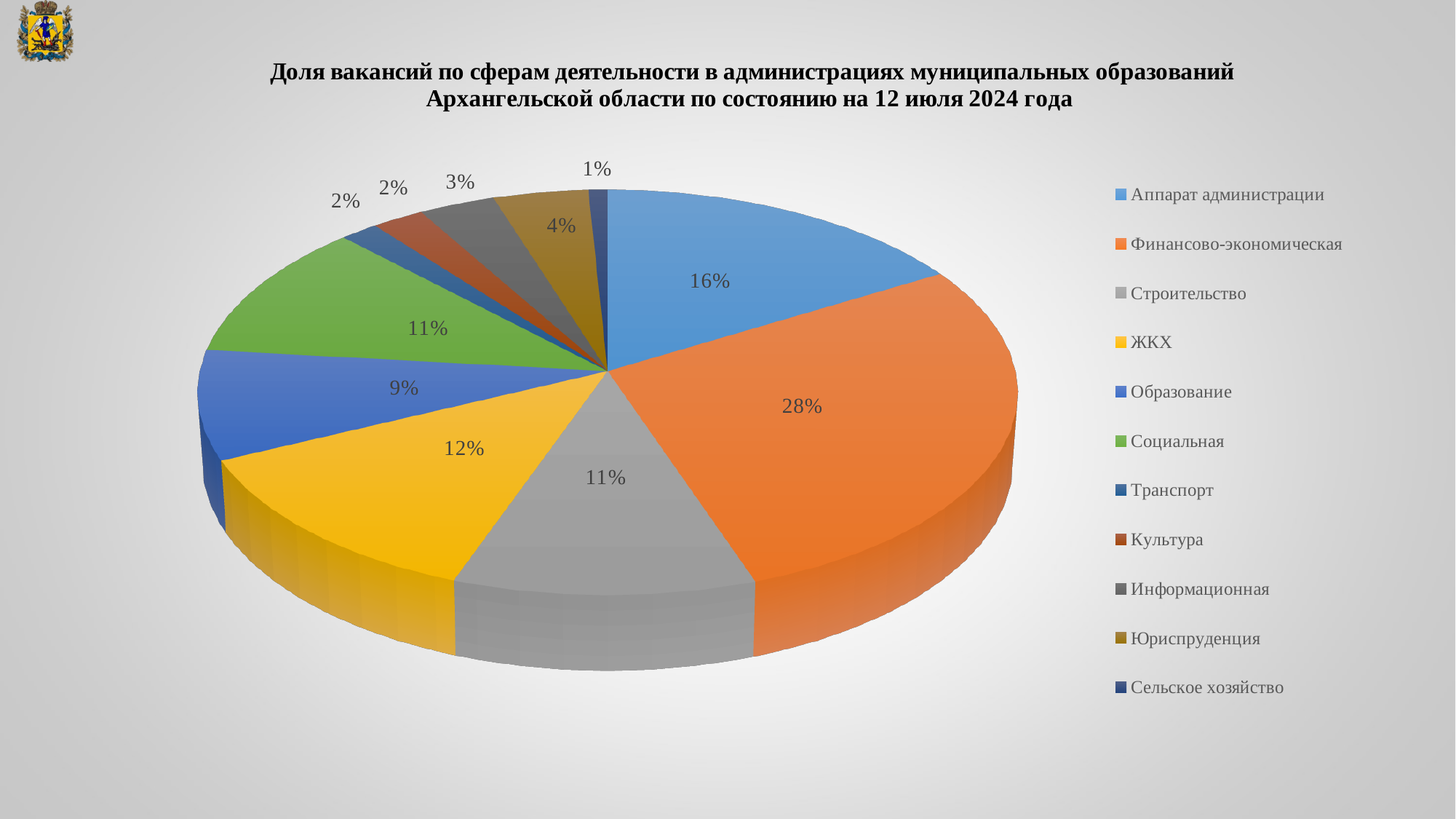
Which sector has the smallest share of vacancies? Сельское хозяйство What share of vacancies does Аппарат администрации have? 16% What share of vacancies does Юриспруденция have? 4% What share of vacancies does ЖКХ have? 12% What type of chart is shown on the slide? Pie chart What share of vacancies does Образование have? 9% What colour is the slice for Социальная? Green Which has a larger share of vacancies, ЖКХ or Образование? ЖКХ What is the difference in percentage points between the Финансово-экономическая share and the Аппарат администрации share? 12 What share of vacancies does the Финансово-экономическая sector have? 28% How many sectors are listed in the legend? 11 Which sector has the largest share of vacancies? Финансово-экономическая